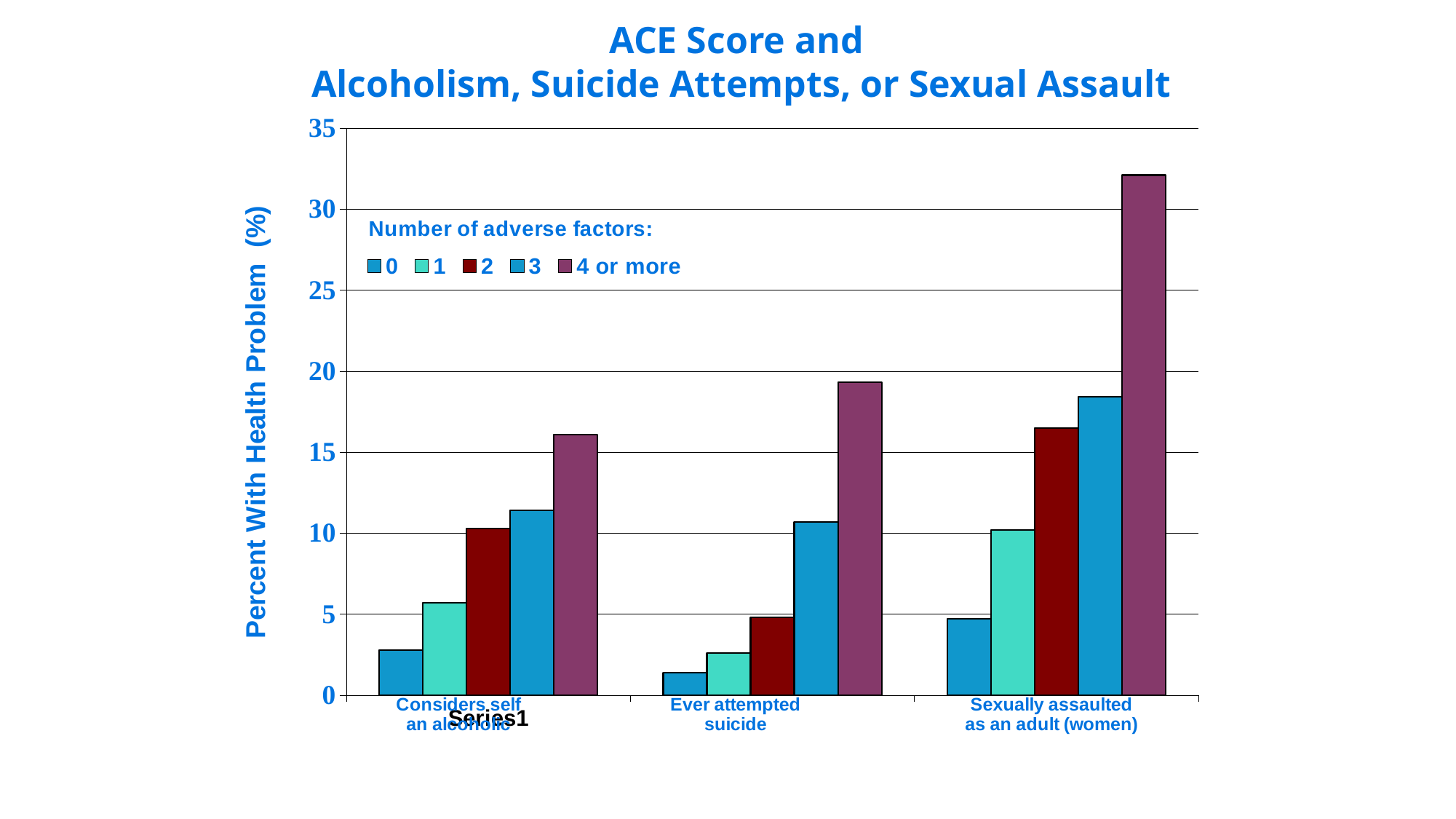
What kind of chart is shown on the slide? bar chart Which series has the lowest value in the 'Ever attempted suicide' category? 0 Which is larger: the '4 or more' value for 'Considers self an alcoholic' or the '4 or more' value for 'Ever attempted suicide'? Ever attempted suicide Is the value for '0' in the 'Ever attempted suicide' category greater or less than 5? less Which series has the highest value in the 'Sexually assaulted as an adult (women)' category? 4 or more How many health-problem categories are shown on the x axis? 3 Is the value for '4 or more' in the 'Ever attempted suicide' category greater or less than 15? greater How many series does the legend list? 5 Is the value for '4 or more' in the 'Sexually assaulted as an adult (women)' category greater or less than 30? greater Which category has the tallest bar on the chart? Sexually assaulted as an adult (women) Within each category, do the values rise or fall as the number of adverse factors increases? rise